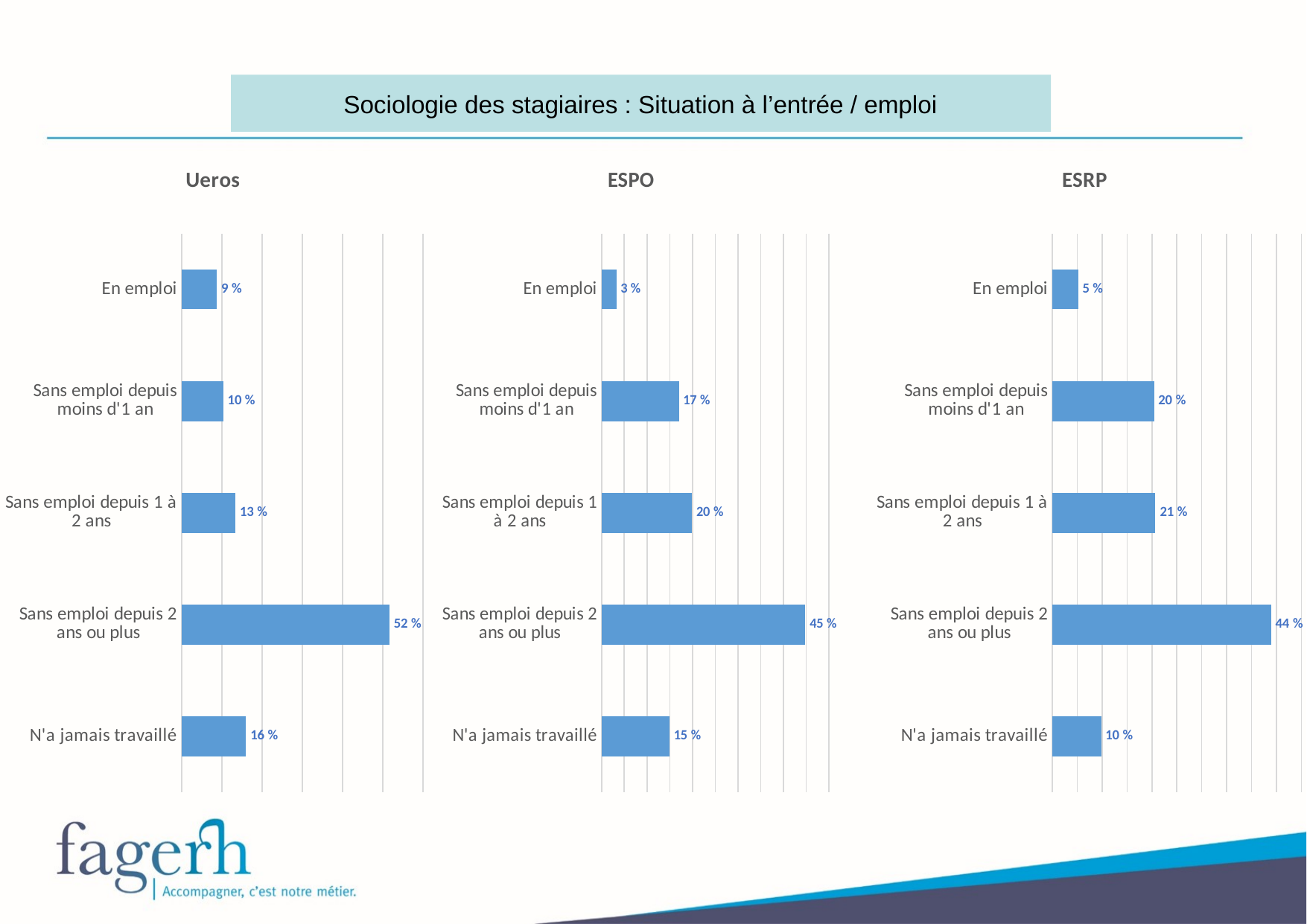
In the ESRP chart, what is the value for "Sans emploi depuis moins d'1 an"? 20 % How many categories does the ESRP chart show? 5 Which of the three charts has the highest value for "En emploi"? Ueros In the Ueros chart, what is the difference between "N'a jamais travaillé" and "En emploi"? 7 % In the ESPO chart, which is larger: "Sans emploi depuis 1 à 2 ans" or "N'a jamais travaillé"? Sans emploi depuis 1 à 2 ans What kind of chart is the Ueros chart? Bar chart In the ESPO chart, which category has the highest value? Sans emploi depuis 2 ans ou plus How many charts are shown on the slide? 3 In the ESRP chart, what is the difference between "Sans emploi depuis 2 ans ou plus" and "N'a jamais travaillé"? 34 % In the ESPO chart, what is the value for "En emploi"? 3 % In the ESRP chart, which category has the lowest value? En emploi In the Ueros chart, what is the value for "Sans emploi depuis 2 ans ou plus"? 52 %